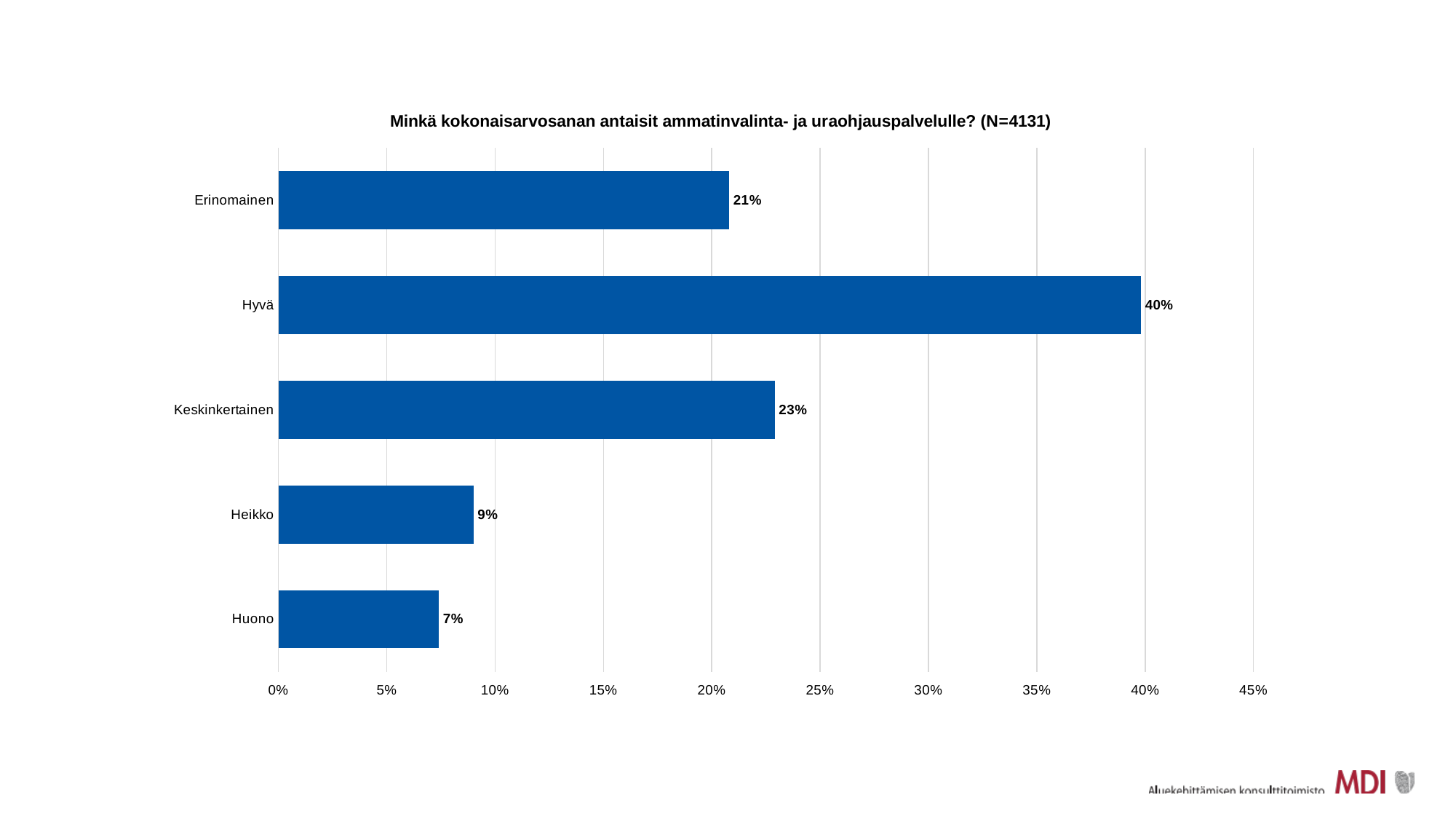
What is the value for Keskinkertainen? 23% Which category has the highest value? Hyvä What is the value for Huono? 7% Which is larger, the value for Heikko or the value for Huono? Heikko What is the N value given in the chart title? 4131 Is the value for Erinomainen greater or less than 25%? less What kind of chart is shown on the slide? bar chart What is the value for Hyvä? 40% Which category has the lowest value? Huono What is the value for Erinomainen? 21% How many categories are shown in the chart? 5 What is the difference between the values for Hyvä and Keskinkertainen? 17%